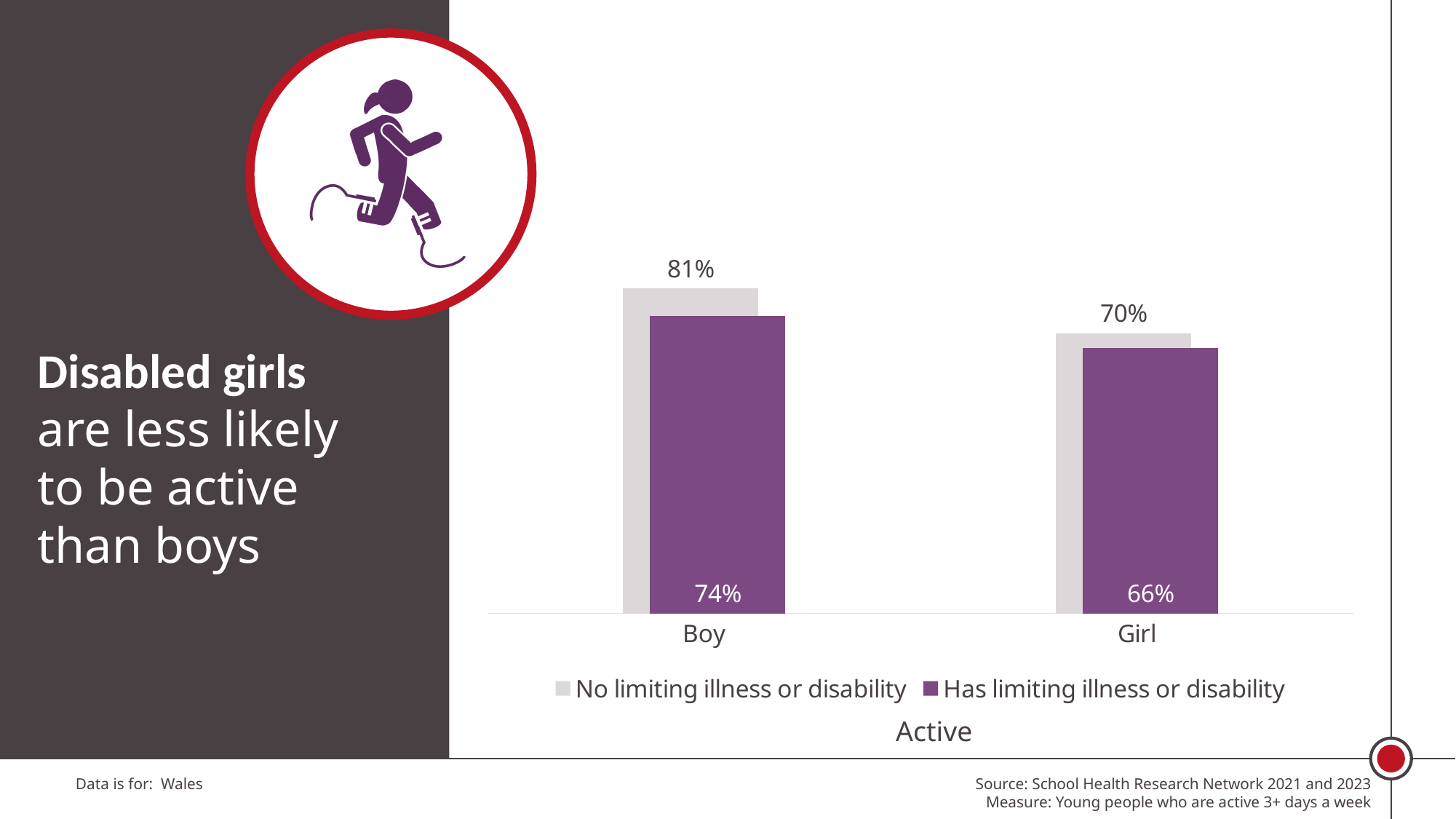
What percentage of girls with a limiting illness or disability are active? 66% Which group has the lowest percentage active on the chart? Girl, has limiting illness or disability What is the difference in percentage points between boys and girls with a limiting illness or disability? 8 What percentage of girls with no limiting illness or disability are active? 70% What is the difference in percentage points between boys with and without a limiting illness or disability? 7 How many series does the legend list? 2 Which group has the highest percentage active on the chart? Boy, no limiting illness or disability What percentage of boys with a limiting illness or disability are active? 74% What kind of chart is shown on the slide? Bar chart What percentage of boys with no limiting illness or disability are active? 81% How many categories are shown on the x axis? 2 Which is larger: the value for girls with no limiting illness or disability, or the value for boys with a limiting illness or disability? Boys with a limiting illness or disability